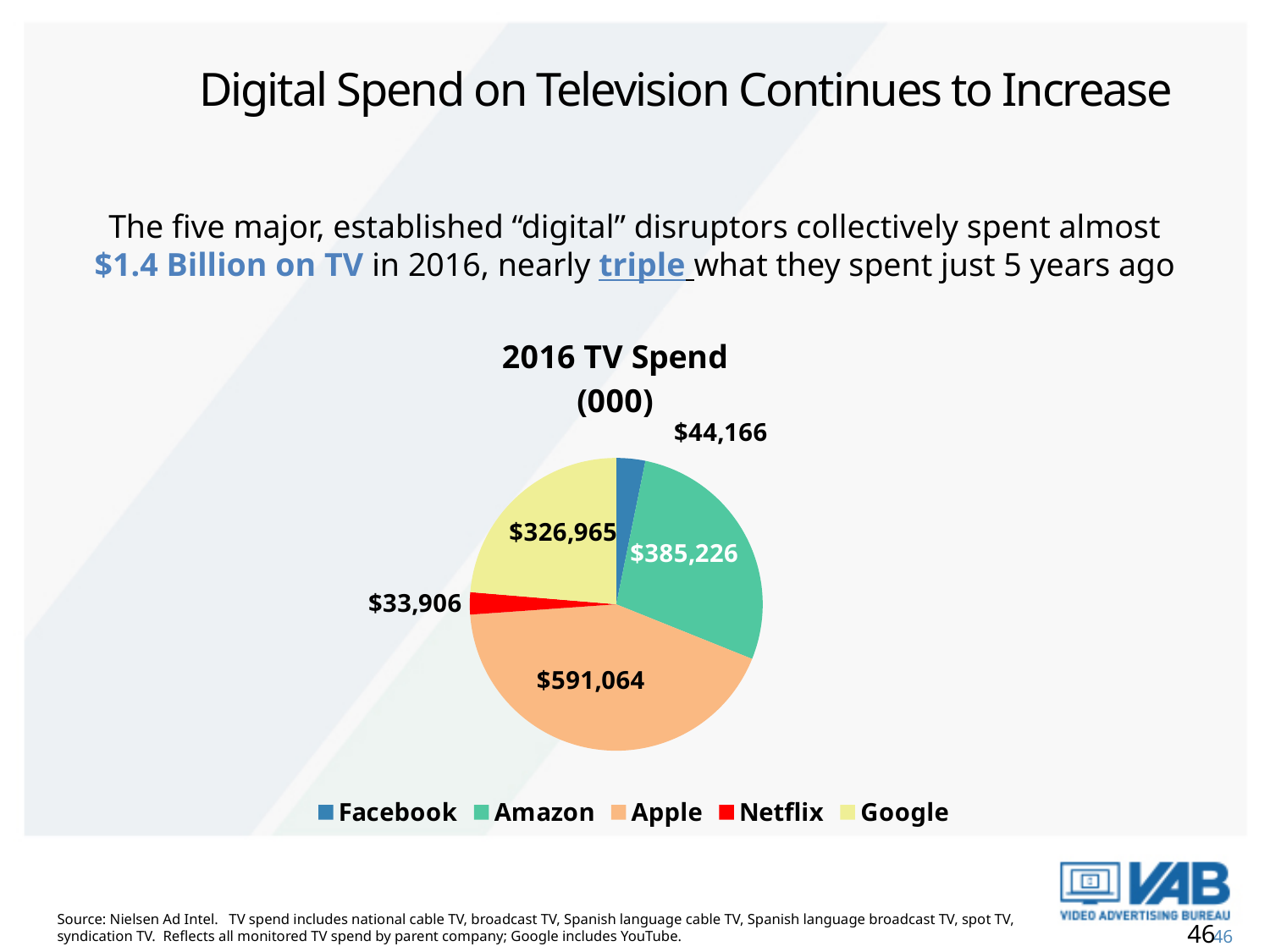
Which company has the largest slice of the 2016 TV Spend pie? Apple What is the 2016 TV spend for Google? $326,965 What is the difference between Apple's and Amazon's 2016 TV spend? $205,838 What is the difference between Facebook's and Netflix's 2016 TV spend? $10,260 What type of chart is used to show 2016 TV Spend? Pie chart How many companies are shown in the 2016 TV Spend pie chart? 5 What is the 2016 TV spend for Netflix? $33,906 What is the 2016 TV spend for Apple? $591,064 Which spent more on TV in 2016, Amazon or Google? Amazon Which company has the smallest slice of the 2016 TV Spend pie? Netflix Which company is represented by the red slice in the pie chart? Netflix What is the 2016 TV spend for Amazon? $385,226